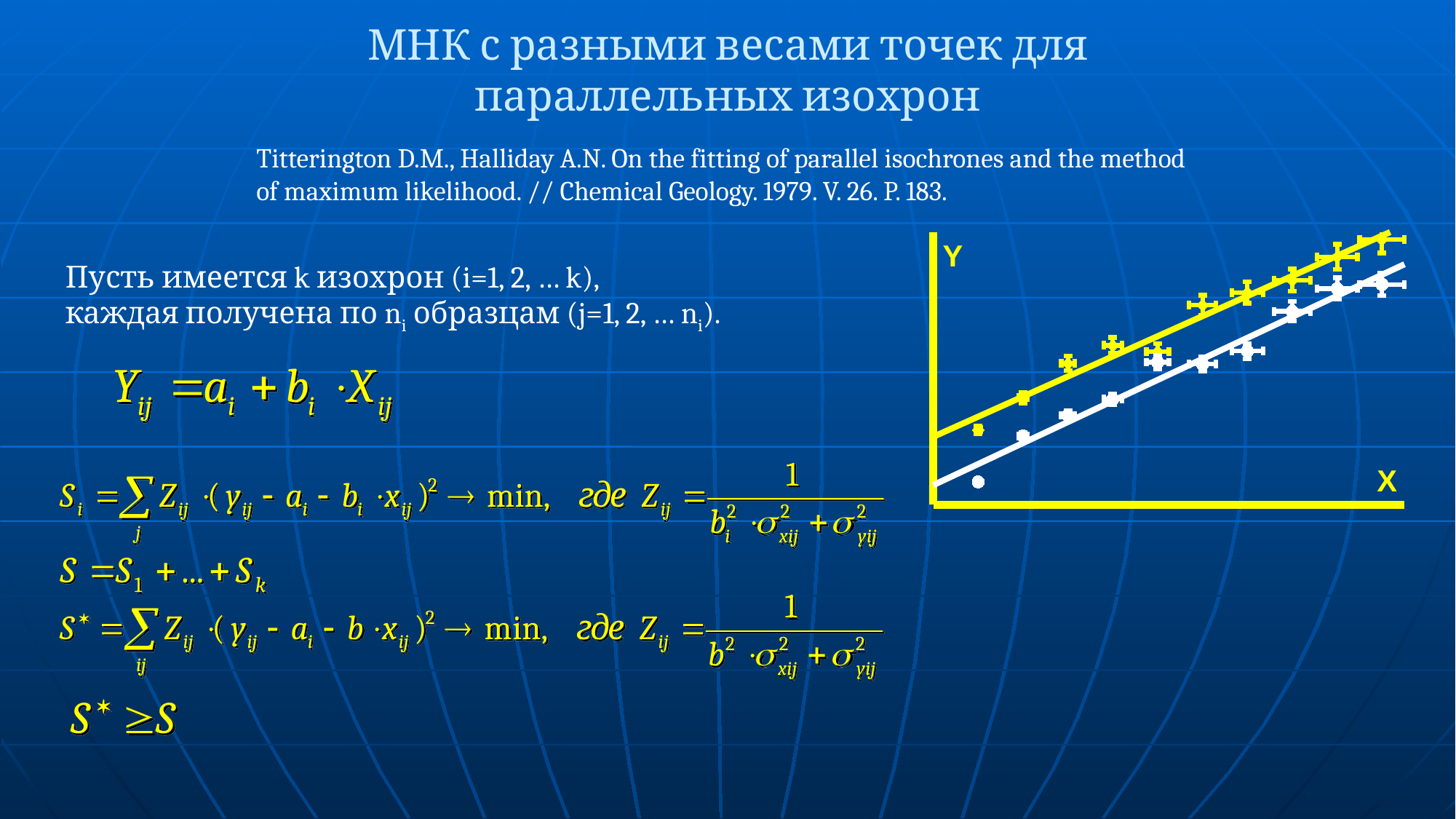
Do the plotted points rise or fall as X increases? rise Are the two fitted lines on the chart parallel or do they cross? parallel What are the labels of the horizontal and vertical axes of the chart? X and Y What kind of chart is shown on the right of the slide? scatter plot with fitted lines How many fitted straight lines are drawn on the chart? 2 Which fitted line lies higher on the chart, the yellow one or the white one? yellow